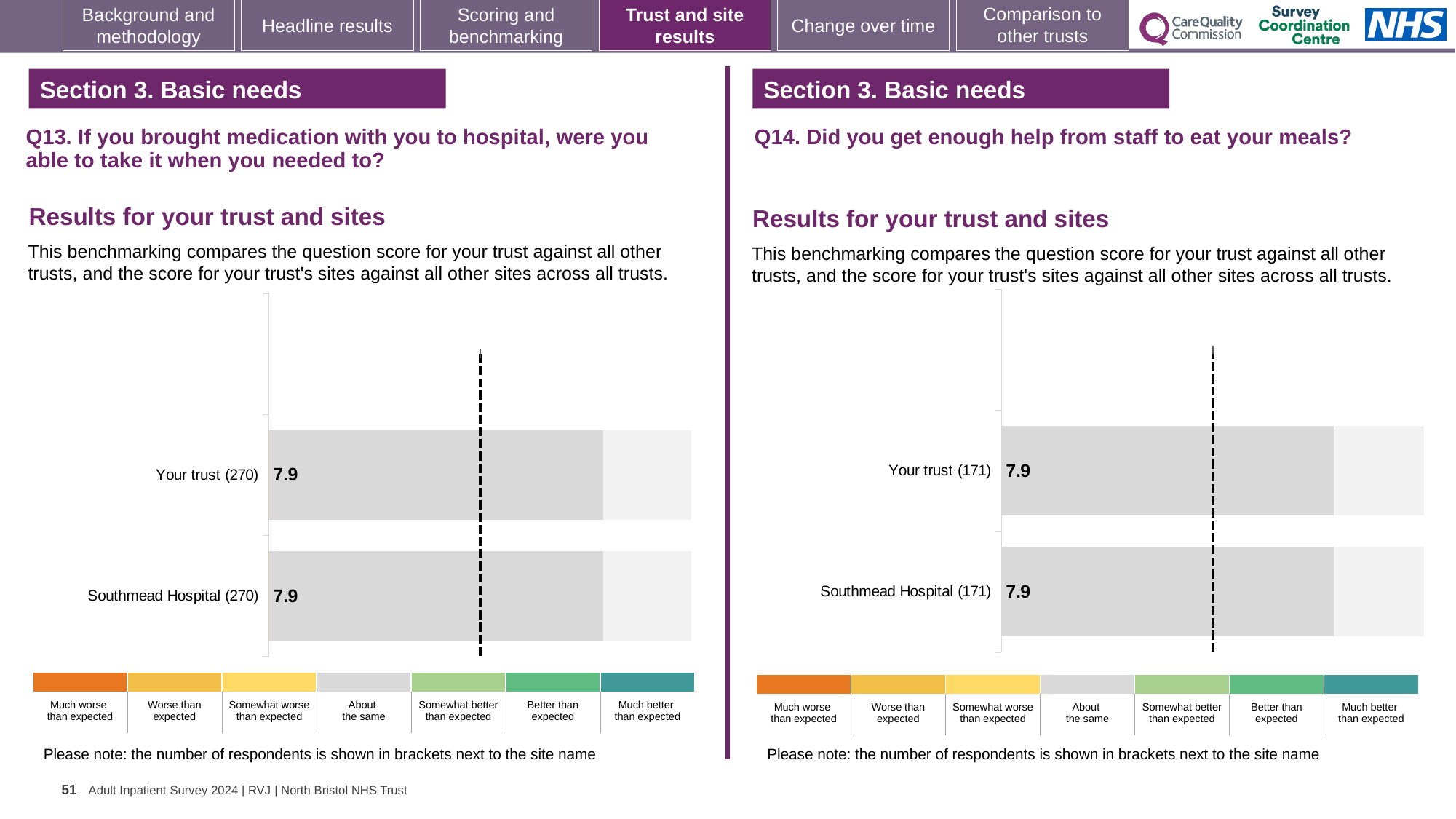
How many bars are plotted in the Q13 chart on the left? 2 In the Q14 chart on the right, what is the score for Southmead Hospital? 7.9 In the Q14 chart on the right, how many respondents are shown in brackets for Southmead Hospital? 171 In the Q13 chart on the left, how many respondents are shown in brackets for Your trust? 270 In the Q13 chart on the left, what is the score for Your trust? 7.9 How many bars are plotted in the Q14 chart on the right? 2 In the Q14 chart on the right, what is the difference between the score for Your trust and the score for Southmead Hospital? 0 In the Q14 chart on the right, what is the score for Your trust? 7.9 What kind of chart is used for the Q13 results on the left? Bar chart In the Q13 chart on the left, what is the difference between the score for Your trust and the score for Southmead Hospital? 0 In the Q13 chart on the left, what is the score for Southmead Hospital? 7.9 In the Q14 chart on the right, is the score for Your trust greater or less than 5? greater